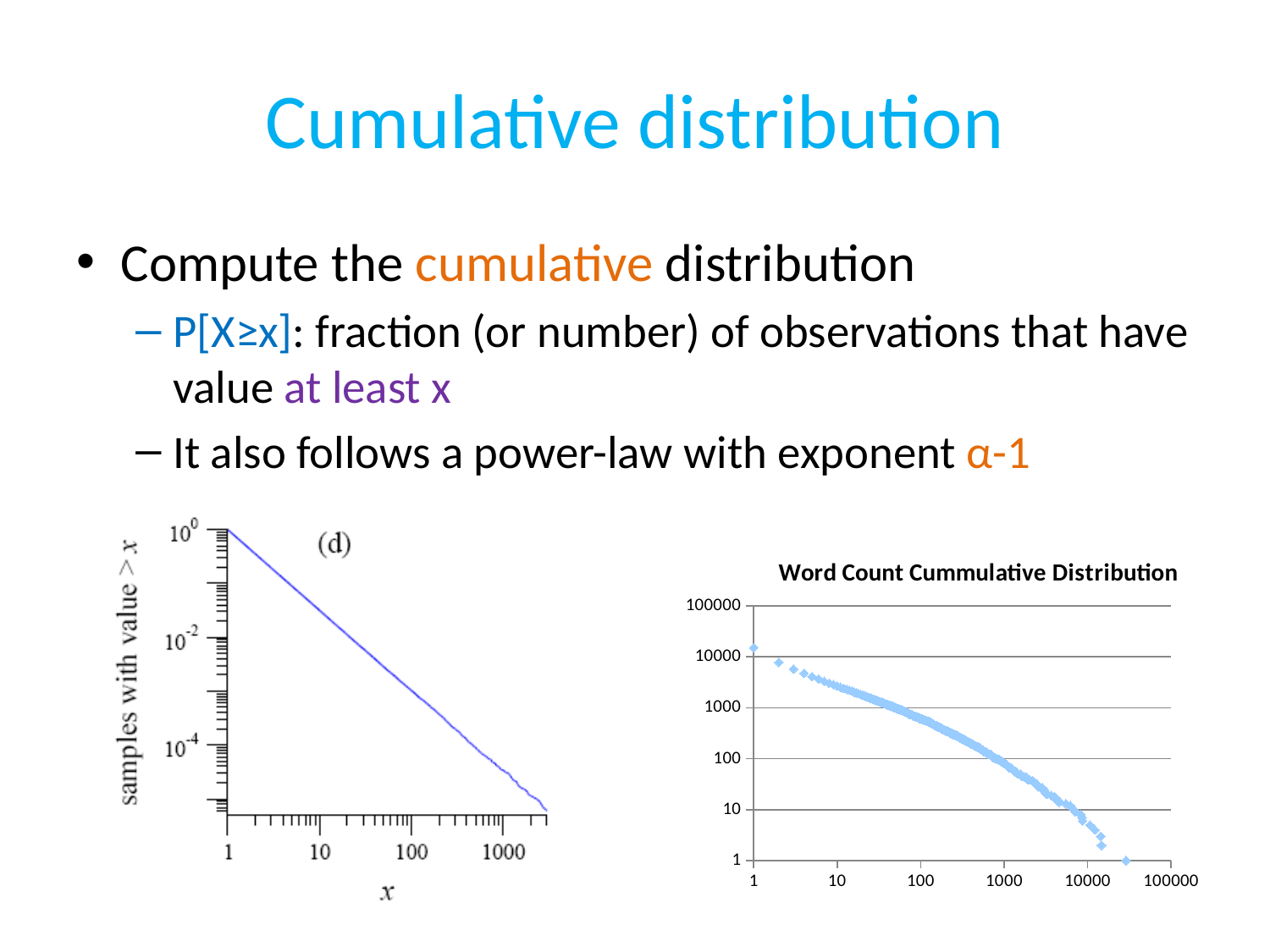
In the 'Word Count Cummulative Distribution' chart, is the value at x = 10 greater or less than 1000? greater In the 'Word Count Cummulative Distribution' chart, is the value at x = 100 greater or less than 1000? less What kind of chart is the 'Word Count Cummulative Distribution' chart on the right? scatter chart What kind of chart is the chart on the left side of the slide, labelled (d)? line chart In the 'Word Count Cummulative Distribution' chart, do the values rise or fall as x increases? fall In the 'Word Count Cummulative Distribution' chart, is the value at x = 1 greater or less than 10000? greater What is the title of the chart on the right side of the slide? Word Count Cummulative Distribution What is the y-axis label of the chart on the left labelled (d)? samples with value > x In the chart on the left labelled (d), do the values rise or fall as x increases? fall In the 'Word Count Cummulative Distribution' chart, which is larger: the value at x = 10 or the value at x = 1000? the value at x = 10 In the chart on the left labelled (d), which is larger: the value at x = 1 or the value at x = 100? the value at x = 1